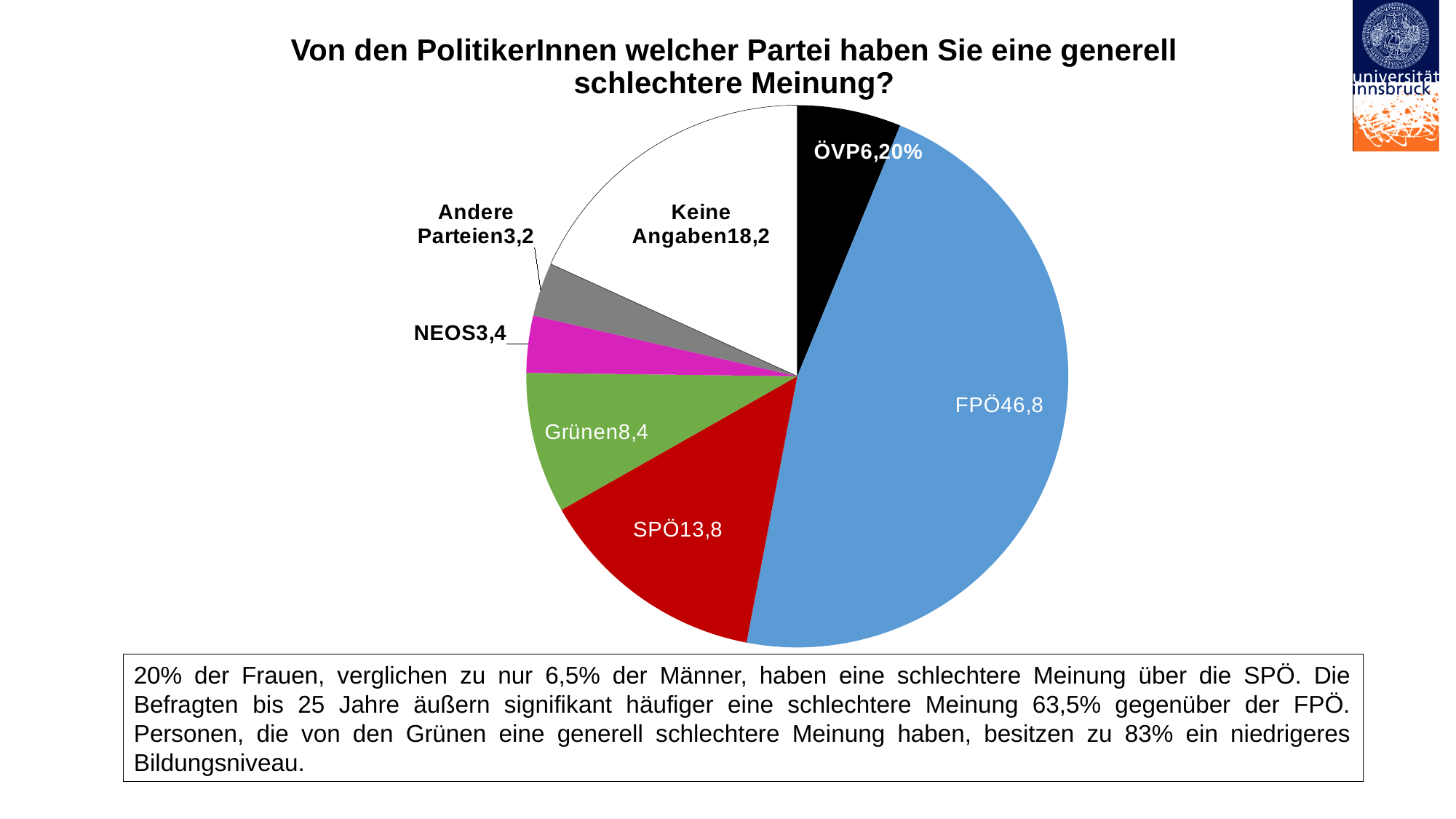
How many slices does the pie chart have? 7 What is the difference between the values for FPÖ and SPÖ? 33,0 What is the difference between the values for Keine Angaben and Grünen? 9,8 What is the value shown for ÖVP? 6,20% What is the value shown for FPÖ? 46,8 What colour is the FPÖ slice? blue What kind of chart is shown on the slide? pie chart Which category has the smallest slice of the pie? Andere Parteien What is the value shown for Keine Angaben? 18,2 Which party has the largest slice of the pie? FPÖ What is the value shown for SPÖ? 13,8 Which is larger, the value for Grünen or the value for NEOS? Grünen